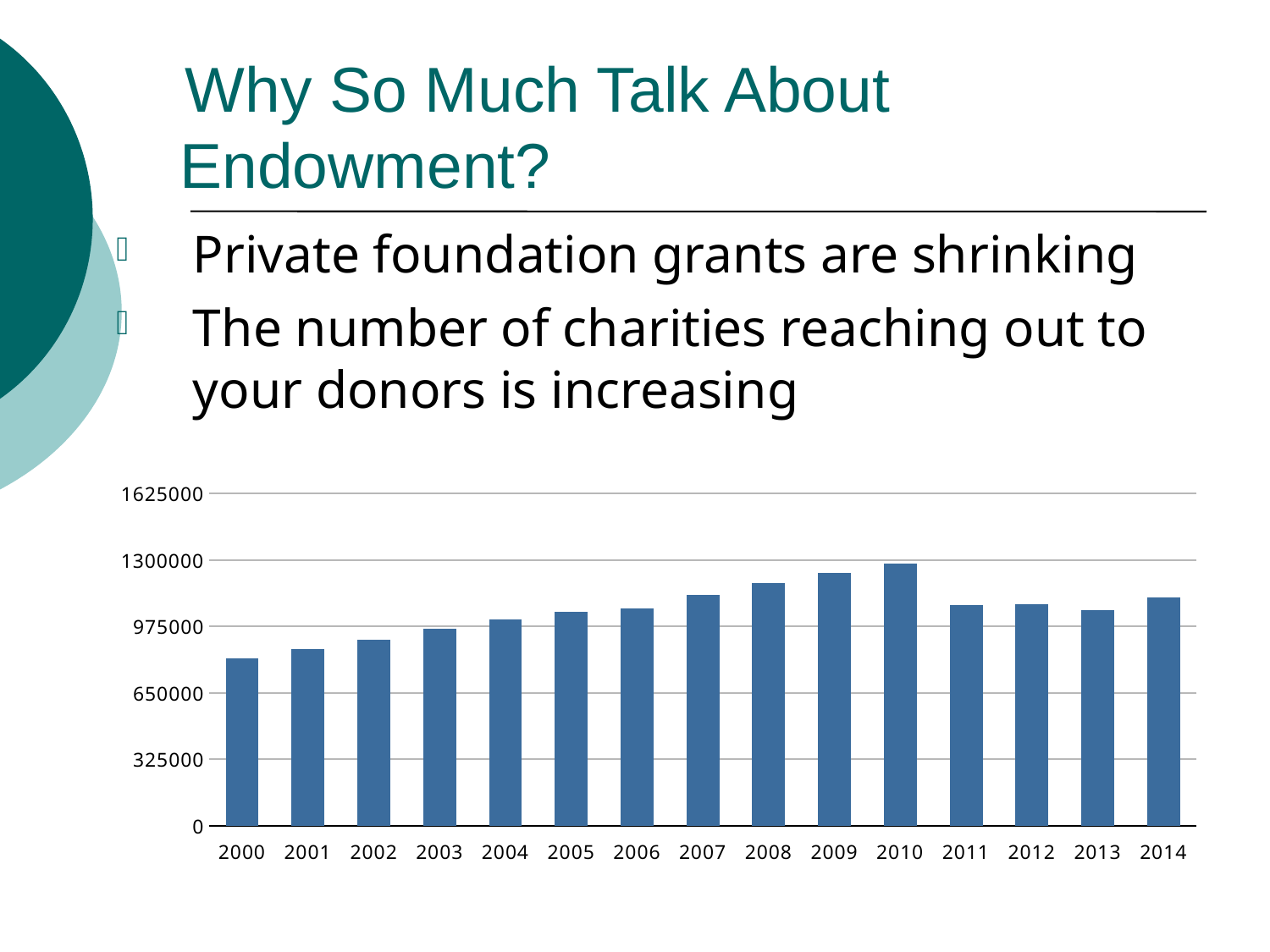
Is the value for 2001 greater or less than 650000? greater Is the value for 2008 greater or less than 975000? greater Which is larger, the value for 2011 or the value for 2002? 2011 What colour are the bars in the chart? blue Is the value for 2000 greater or less than 975000? less What kind of chart is shown on the slide? bar chart Which year has the lowest bar in the chart? 2000 Do the values rise or fall from 2000 to 2010? rise How many years are shown on the x axis of the chart? 15 Which year has the highest bar in the chart? 2010 Which is larger, the value for 2009 or the value for 2005? 2009